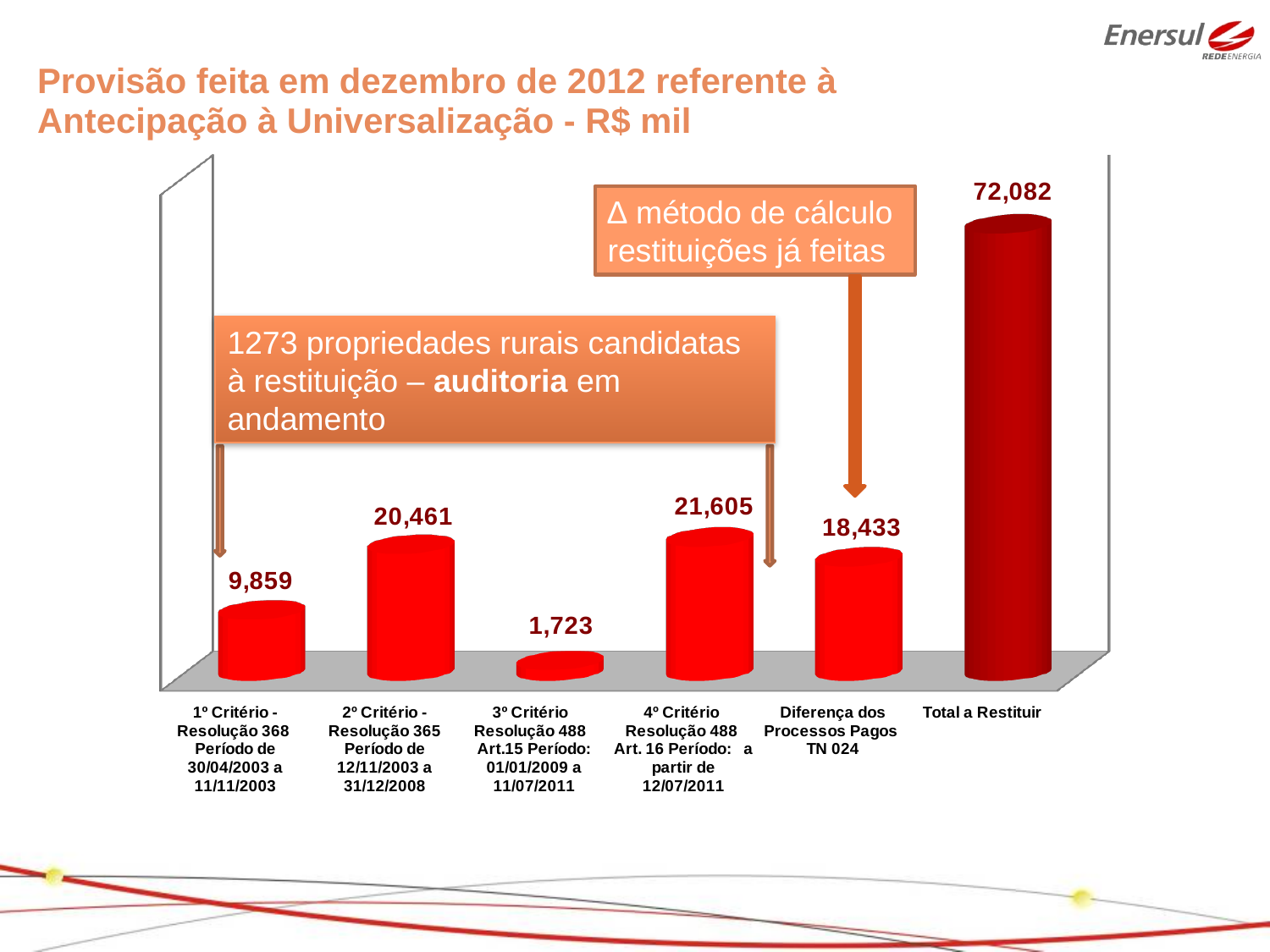
Which category has the highest value? Total a Restituir What is the value for 'Total a Restituir'? 72,082 How many bars are shown in the chart? 6 What is the difference between the values for '4º Critério Resolução 488 Art. 16' and '2º Critério - Resolução 365'? 1,144 What is the value for 'Diferença dos Processos Pagos TN 024'? 18,433 What unit is stated in the slide title for the values? R$ mil What kind of chart is shown on the slide? Bar chart What is the value for '1º Critério - Resolução 368'? 9,859 What is the difference between 'Total a Restituir' and 'Diferença dos Processos Pagos TN 024'? 53,649 What is the value for '3º Critério Resolução 488 Art.15'? 1,723 Which is larger, the value for '2º Critério - Resolução 365' or '1º Critério - Resolução 368'? 2º Critério - Resolução 365 Which category has the lowest value? 3º Critério Resolução 488 Art.15